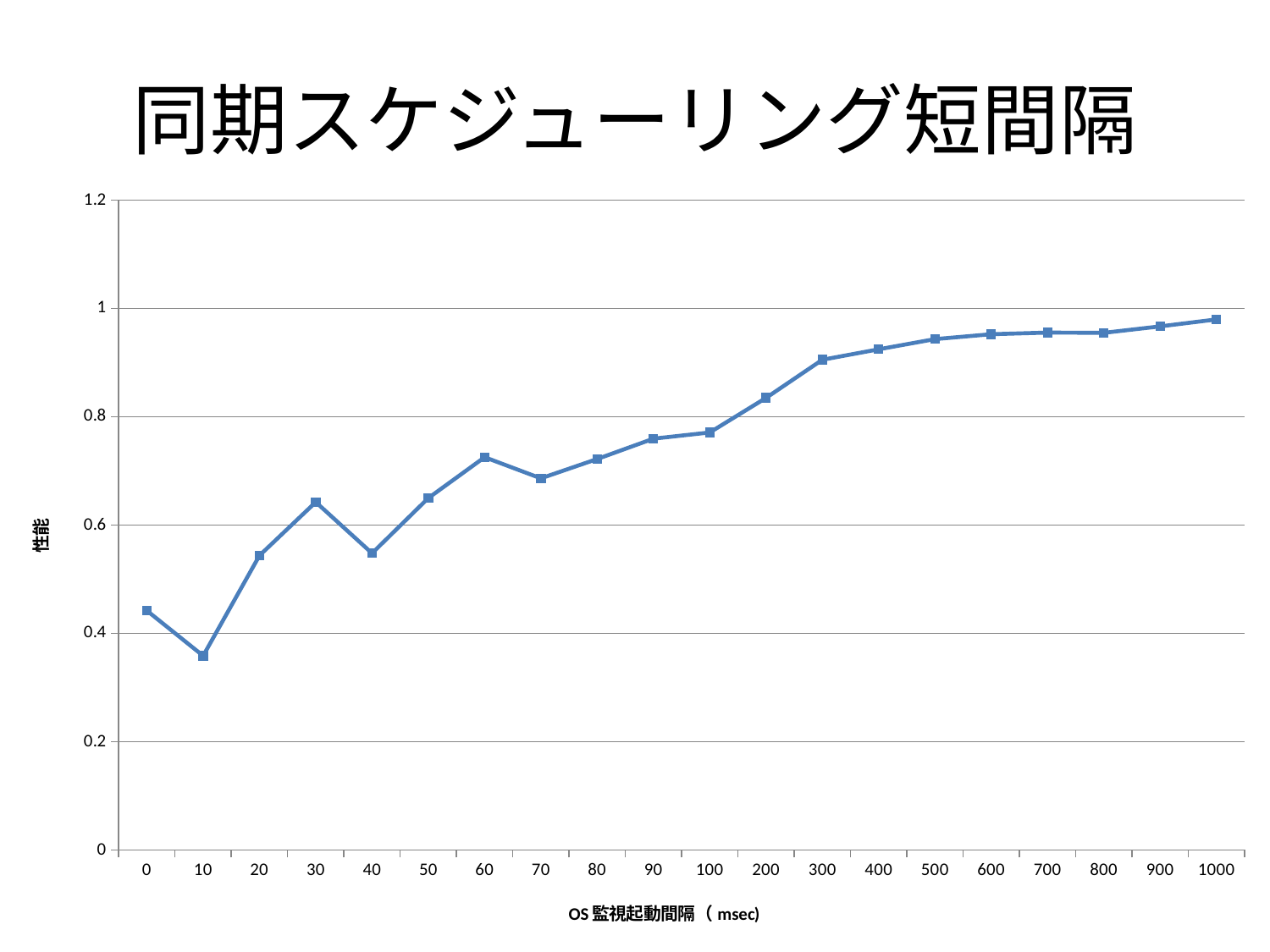
What kind of chart is shown on the slide? line chart At which x-axis value is the plotted value lowest? 10 Is the value at x = 1000 greater or less than 1? less Is the value at x = 300 greater or less than 0.8? greater How many data points are plotted on the line? 20 At which x-axis value is the plotted value highest? 1000 Is the value at x = 40 greater or less than 0.6? less Overall, do the values rise or fall as the x-axis value increases from 0 to 1000? rise What is the label of the y axis? 性能 Which has the larger value, x = 30 or x = 40? 30 Which has the larger value, x = 100 or x = 200? 200